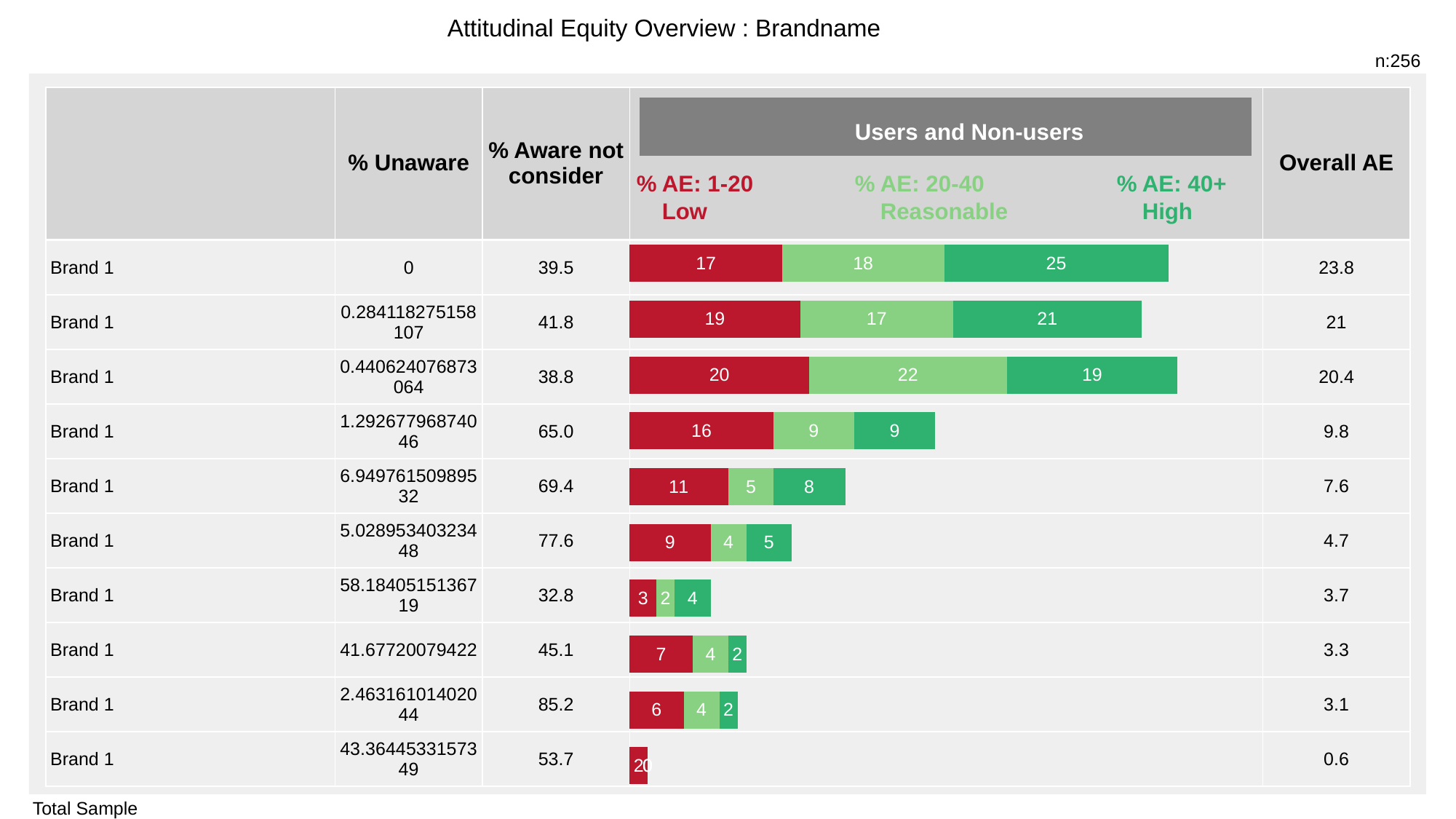
In the first row (Overall AE 23.8), what is the value of the '% AE: 40+ High' segment? 25 In the row with Overall AE 21, what is the difference between the 'Low' segment (19) and the 'Reasonable' segment (17)? 2 In the row with Overall AE 3.7, which segment is larger: 'Low' or 'High'? High Which row has the highest Overall AE value? The first row (23.8) What is the total of the three segments in the first row (Overall AE 23.8)? 60 What kind of chart is embedded in the 'Users and Non-users' column of the table? Stacked bar chart In the row with Overall AE 20.4, what is the value of the '% AE: 20-40 Reasonable' segment? 22 In the row with Overall AE 9.8, what is the value of the '% AE: 1-20 Low' segment? 16 What colour is used for the '% AE: 1-20 Low' segment of the bars? Red How many rows of bars are shown in the table? 10 What is the total of the three segments in the row with Overall AE 7.6? 24 How many segment categories (AE bands) does each bar in the 'Users and Non-users' column have? 3